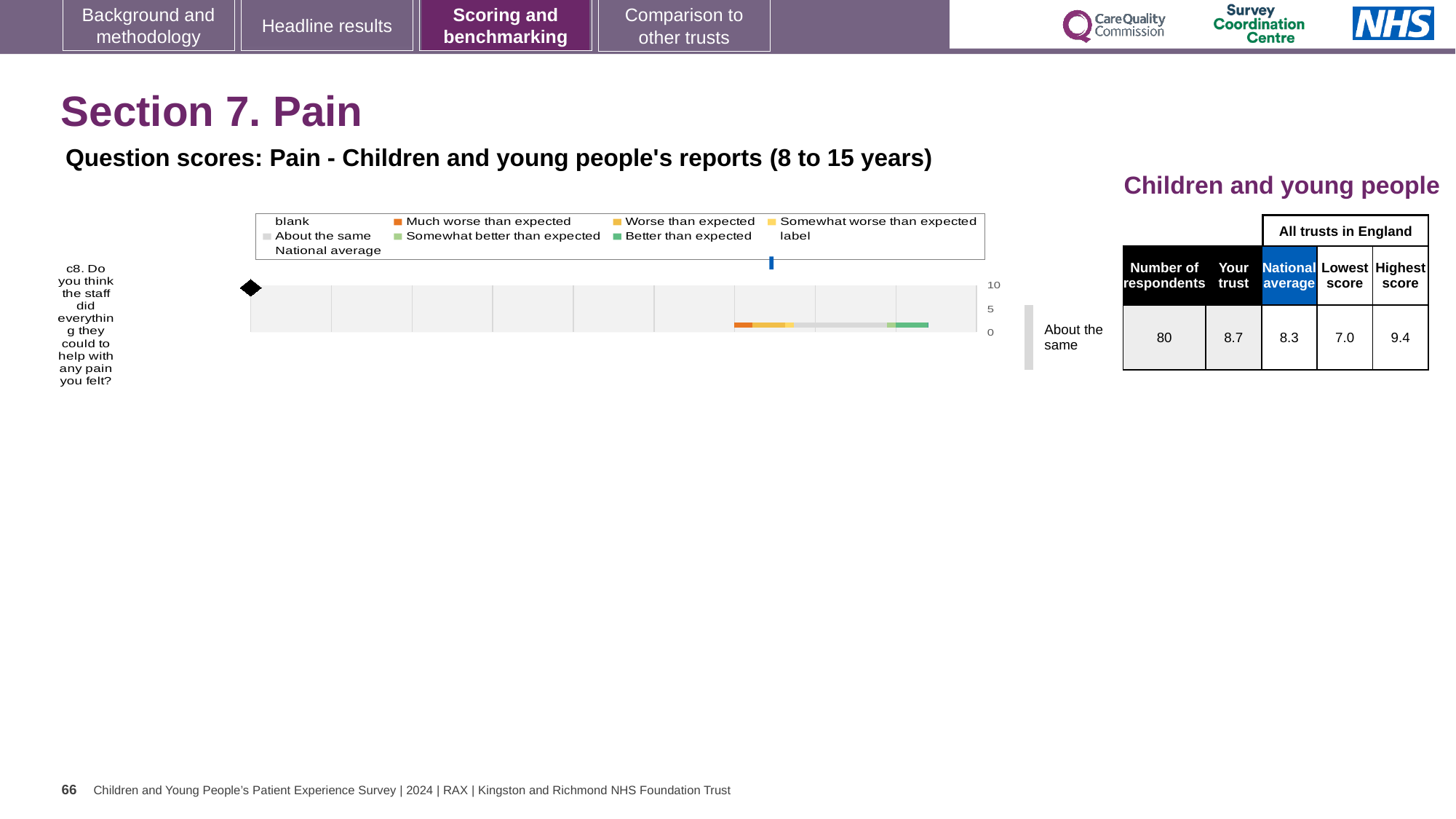
Which is larger for question c8, the 'Your trust' score or the national average? Your trust What benchmark category is given for question c8 next to the chart? About the same According to the table, what is the lowest score among all trusts in England for question c8? 7.0 What kind of chart is shown on the slide? bar chart Which legend entry is shown with an orange colour? Much worse than expected According to the table, what is the 'Your trust' score for question c8? 8.7 According to the table, what is the highest score among all trusts in England for question c8? 9.4 According to the table, what is the national average score for question c8? 8.3 According to the table, how many respondents answered question c8? 80 What is the highest value shown on the chart's axis? 10 How many survey questions are plotted on the chart? 1 What is the difference between the 'Your trust' score and the national average for question c8? 0.4